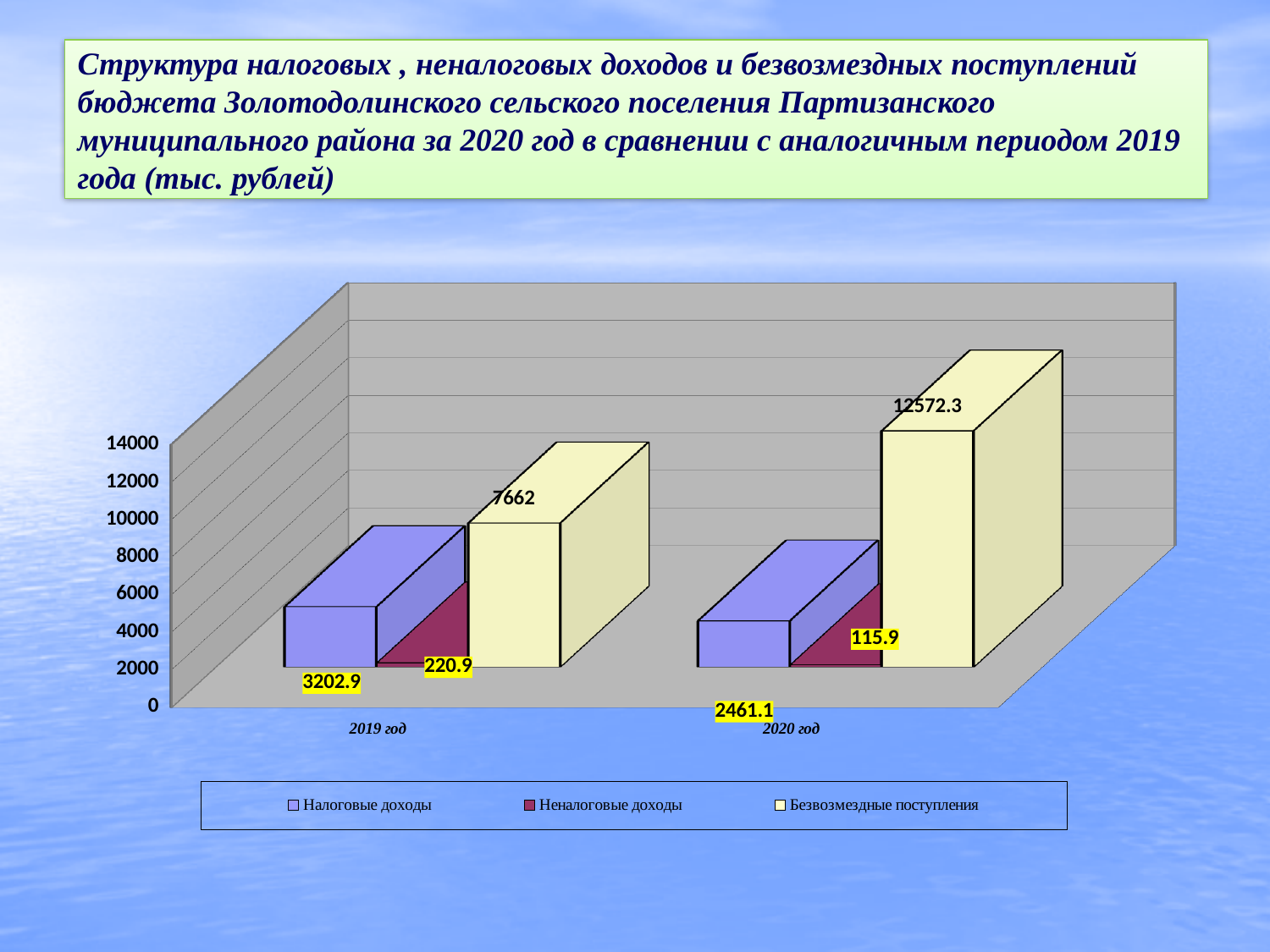
How many categories are shown on the x axis? 2 Which series has the lowest value in 2019 год? Неналоговые доходы What is the value of Безвозмездные поступления for 2019 год? 7662 What is the value of Безвозмездные поступления for 2020 год? 12572.3 How many series does the legend list? 3 Which is larger: Налоговые доходы in 2019 год or in 2020 год? 2019 год What is the value of Неналоговые доходы for 2020 год? 115.9 What kind of chart is shown on the slide? Bar chart Does the value of Неналоговые доходы rise or fall from 2019 год to 2020 год? Fall What is the value of Налоговые доходы for 2019 год? 3202.9 What is the difference between Безвозмездные поступления in 2020 год and in 2019 год? 4910.3 Which series has the highest value in 2020 год? Безвозмездные поступления